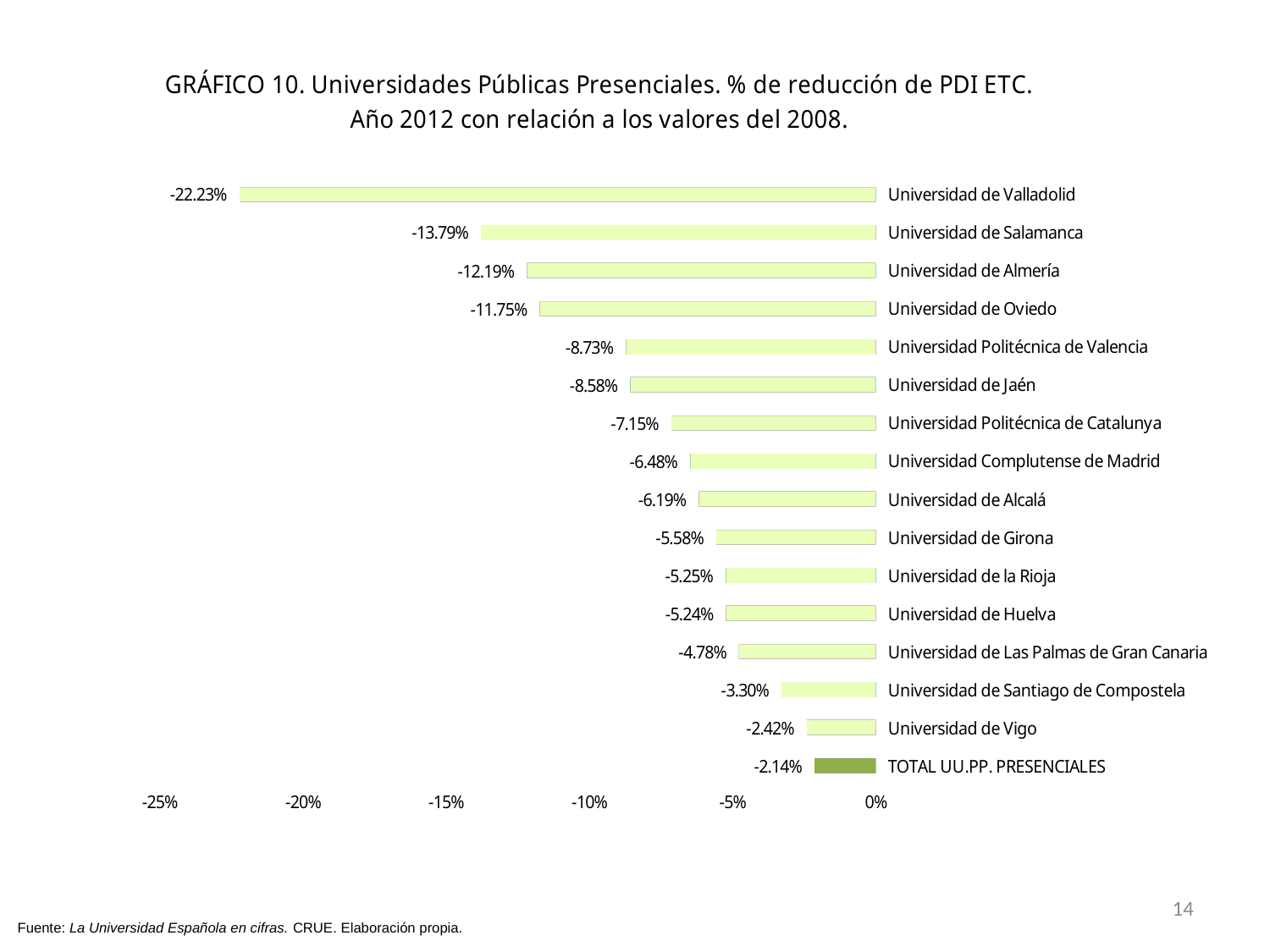
Which has a larger reduction, Universidad de Almería or Universidad de Girona? Universidad de Almería What is the difference in percentage points between the values for Universidad de Valladolid and Universidad de Salamanca? 8.44 percentage points How many bars are plotted in the chart? 16 Is the reduction for Universidad de Oviedo more or less than 10%? more What is the % de reducción de PDI ETC value shown for Universidad de Valladolid? -22.23% Which bar is drawn in a darker green colour than the others? TOTAL UU.PP. PRESENCIALES Which category shows the smallest reduction in PDI ETC? TOTAL UU.PP. PRESENCIALES What value is shown for TOTAL UU.PP. PRESENCIALES? -2.14% What kind of chart is shown on the slide? Bar chart Which university shows the largest reduction in PDI ETC? Universidad de Valladolid What value is shown for Universidad Complutense de Madrid? -6.48% What value is shown for Universidad de Santiago de Compostela? -3.30%